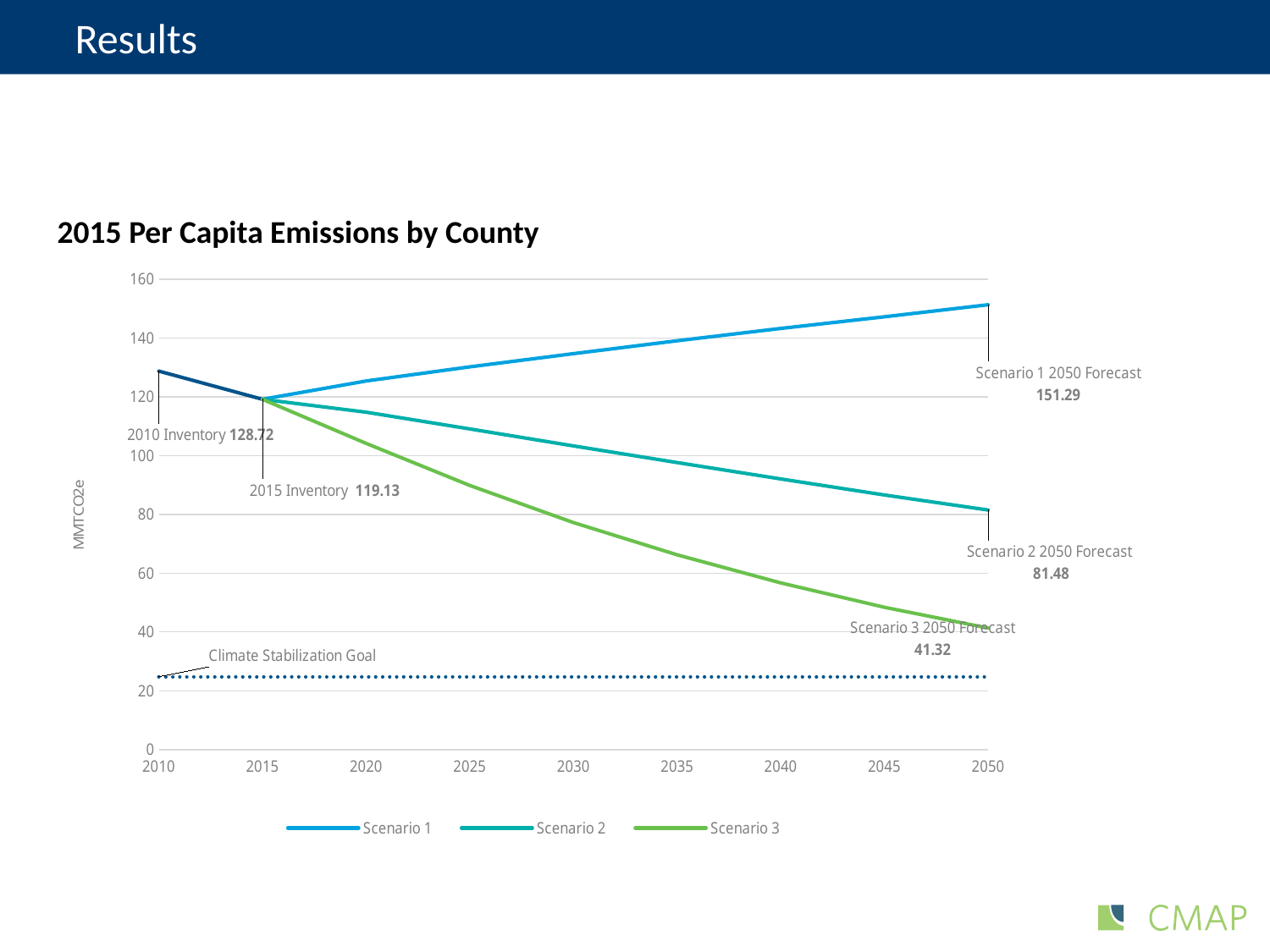
What is the Scenario 3 2050 Forecast value? 41.32 Does the Scenario 1 line rise or fall from 2015 to 2050? Rise Which scenario has the lowest 2050 forecast value? Scenario 3 What type of chart is shown on the slide? Line chart What is the Scenario 1 2050 Forecast value? 151.29 What is the 2015 Inventory value? 119.13 What is the difference between the Scenario 1 2050 Forecast and the Scenario 3 2050 Forecast? 109.97 Is the Climate Stabilization Goal line greater or less than 40? less How many series does the legend list? 3 What is the Scenario 2 2050 Forecast value? 81.48 Which scenario has the highest 2050 forecast value? Scenario 1 What is the 2010 Inventory value? 128.72